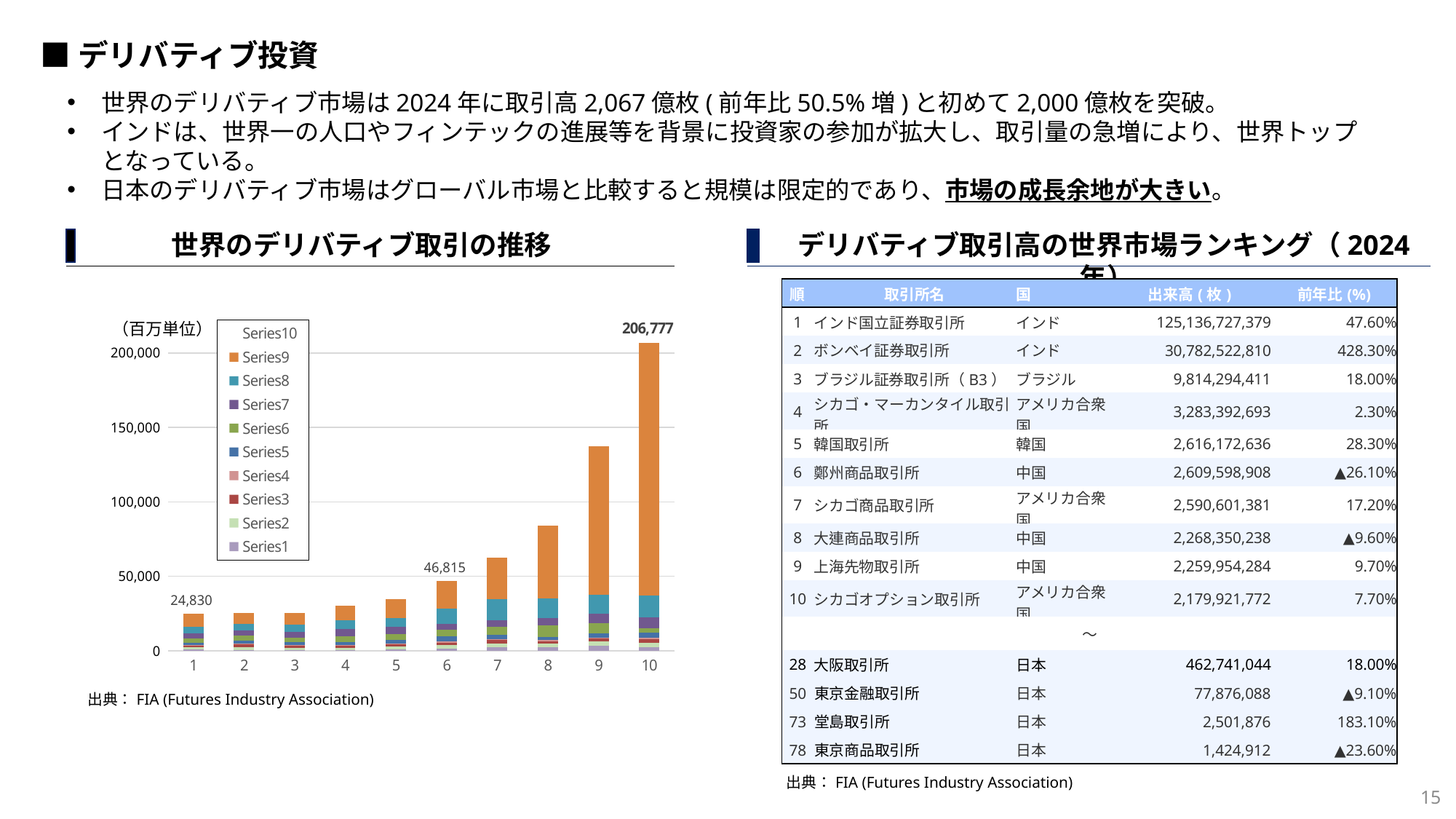
In the 世界のデリバティブ取引の推移 chart, what is the difference between the labelled totals for category 10 and category 1? 181,947 Do the stacked bar totals in the 世界のデリバティブ取引の推移 chart generally rise or fall from category 1 to category 10? rise In the 世界のデリバティブ取引の推移 chart, what is the difference between the labelled totals for category 6 and category 1? 21,985 In the 世界のデリバティブ取引の推移 chart, is the total for category 9 greater or less than 100,000? greater In the 世界のデリバティブ取引の推移 chart, what is the total value labelled for category 10? 206,777 In the 世界のデリバティブ取引の推移 chart, what is the total value labelled for category 1? 24,830 What kind of chart is shown under the title 世界のデリバティブ取引の推移? bar chart What unit label is shown at the top left of the 世界のデリバティブ取引の推移 chart? 百万単位 In the 世界のデリバティブ取引の推移 chart, what is the total value labelled for category 6? 46,815 How many categories are shown on the x axis of the 世界のデリバティブ取引の推移 chart? 10 Which category has the highest stacked bar in the 世界のデリバティブ取引の推移 chart? 10 How many series does the legend of the 世界のデリバティブ取引の推移 chart list? 10